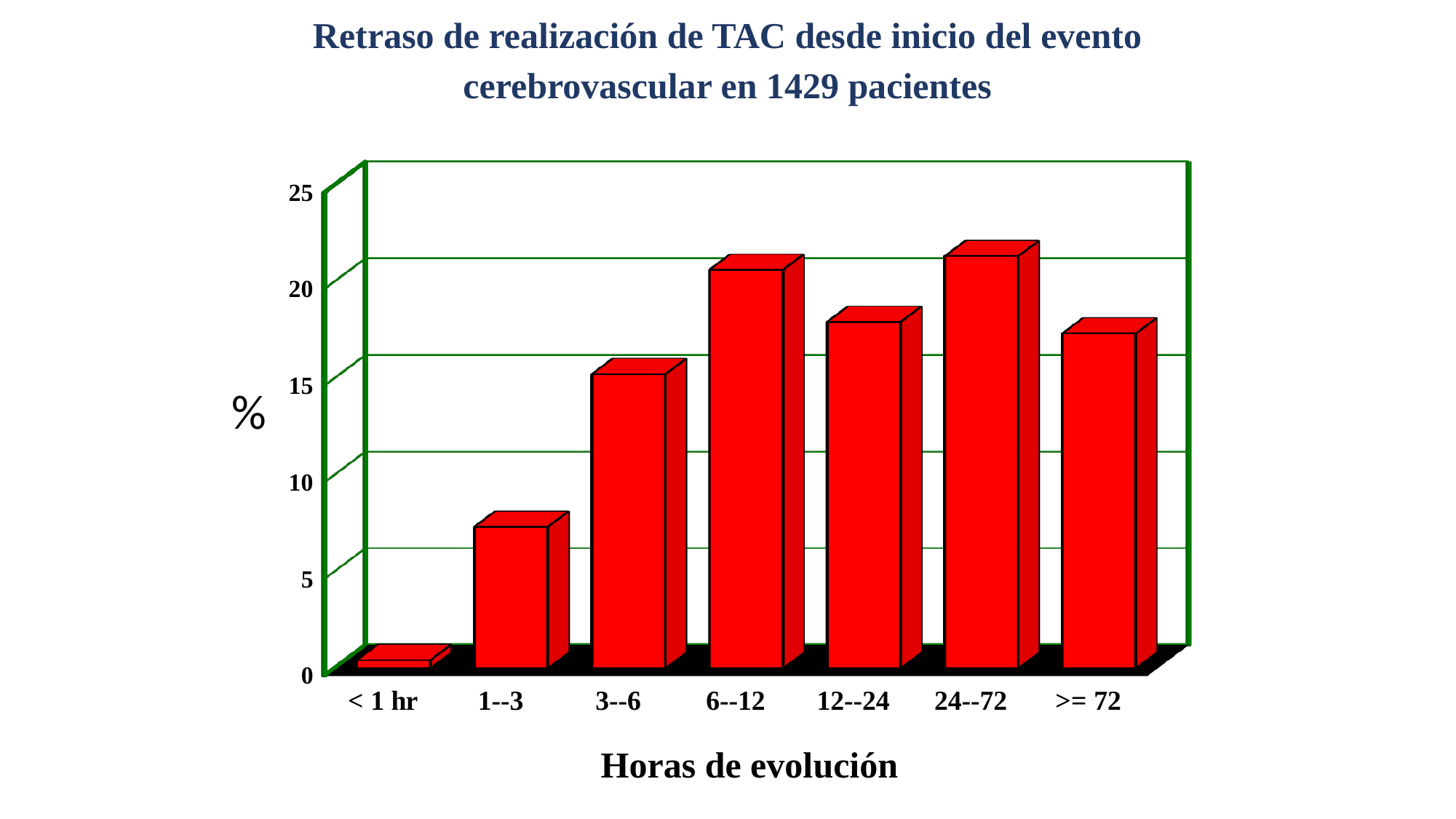
Is the value for 6--12 greater or less than 20? greater Is the value for >= 72 greater or less than 15? greater Which is larger, the value for 1--3 or the value for 3--6? 3--6 Is the value for 1--3 greater or less than 10? less What is the label of the x axis of the chart? Horas de evolución Which is larger, the value for 6--12 or the value for 12--24? 6--12 How many categories are shown on the x axis of the chart? 7 What is the title of the chart? Retraso de realización de TAC desde inicio del evento cerebrovascular en 1429 pacientes What kind of chart is shown on the slide? bar chart Which category has the lowest value in the chart? < 1 hr